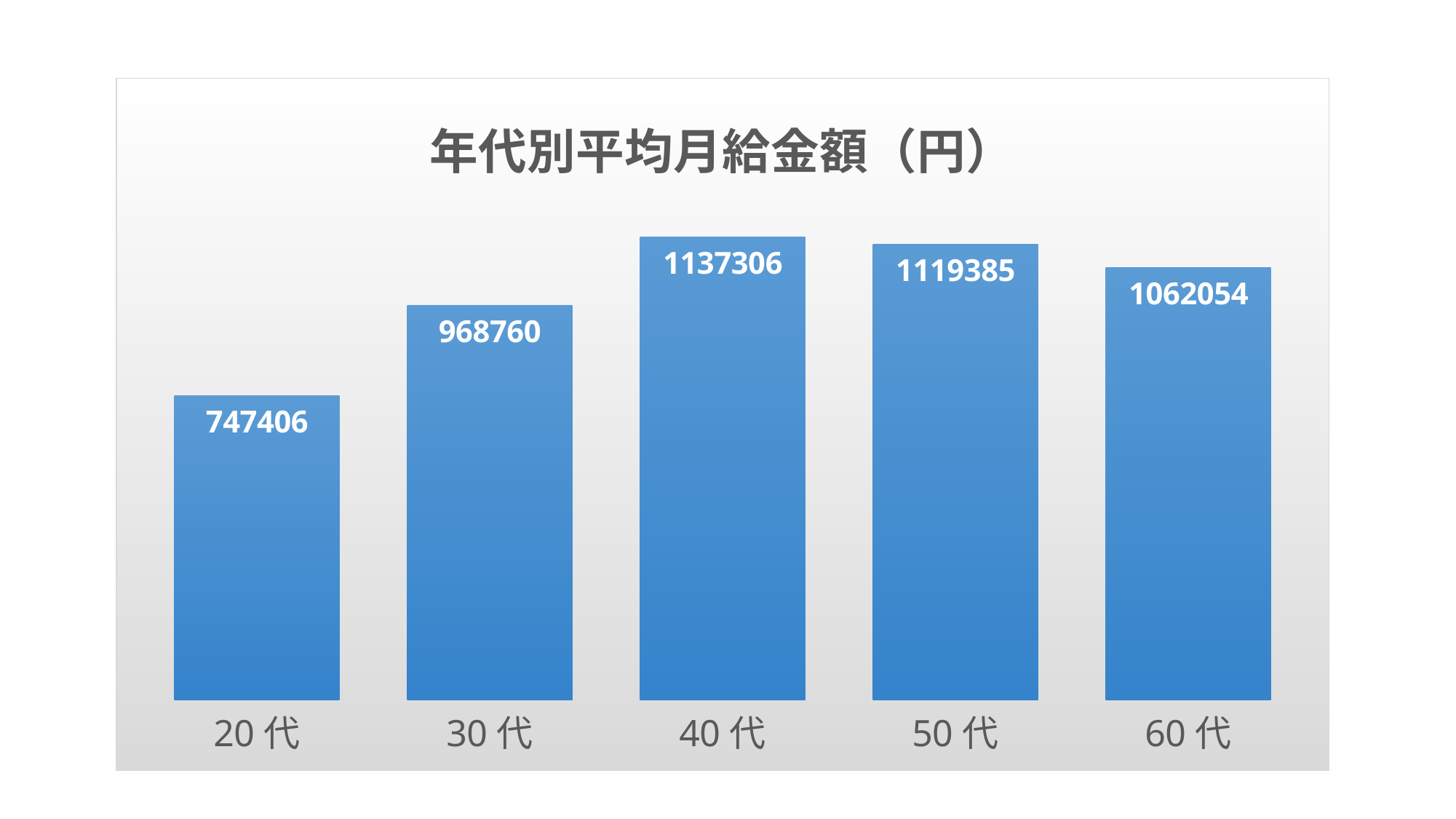
What is the value for 40代? 1137306 What is the difference between the values for 30代 and 20代? 221354 Do the values rise or fall from 40代 to 60代? fall What is the title of the chart? 年代別平均月給金額（円） What kind of chart is this? bar chart What is the difference between the values for 40代 and 50代? 17921 Which age group has the lowest value? 20代 Which age group has the highest value? 40代 What is the value for 20代? 747406 What is the value for 60代? 1062054 Which is larger, the value for 50代 or the value for 60代? 50代 How many age groups are shown in the chart? 5